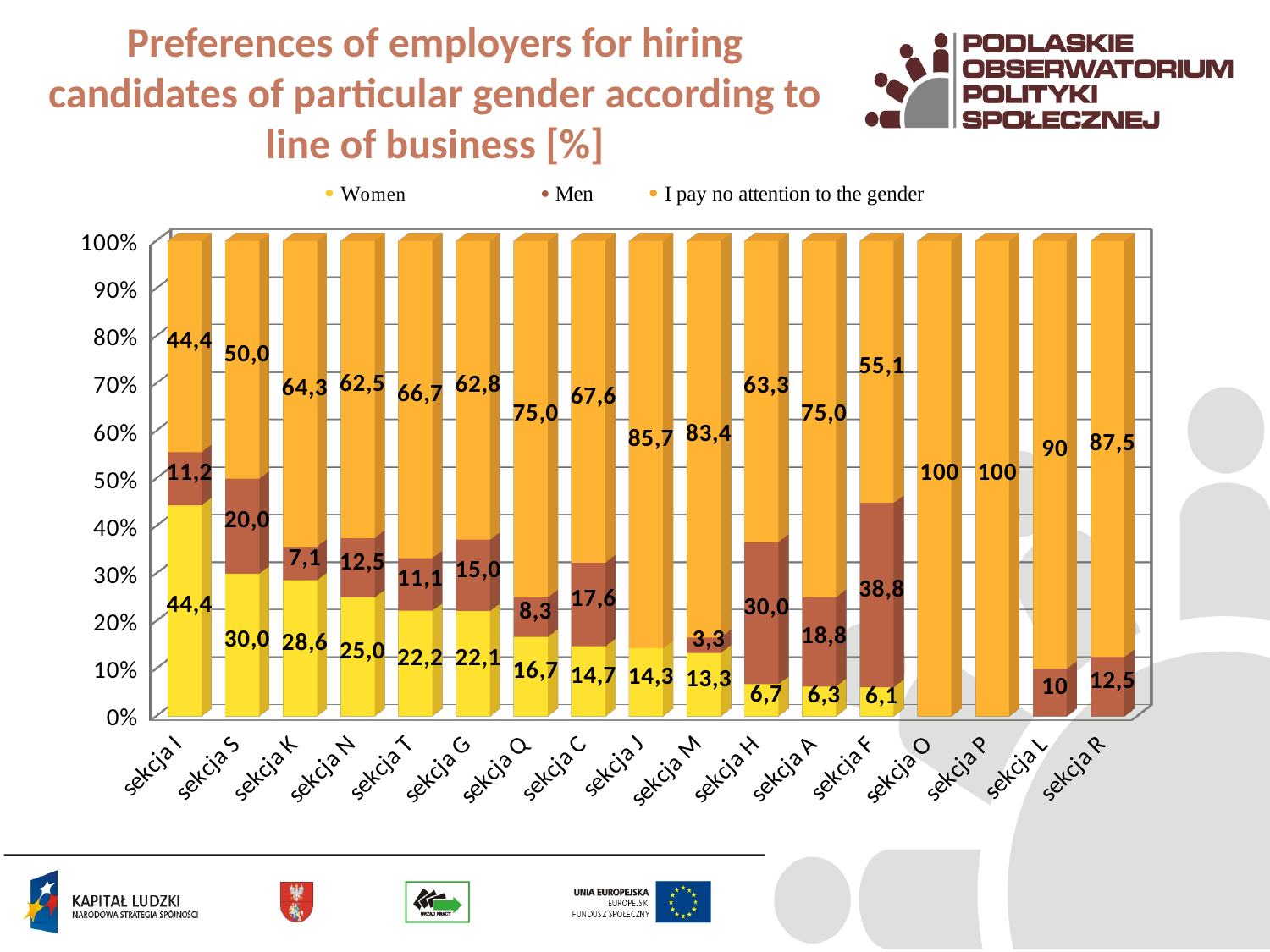
Which is larger, the Women value for sekcja S or the Women value for sekcja K? sekcja S What is the Men value for sekcja F? 38,8 Which category has the highest Women value? sekcja I What is the 'I pay no attention to the gender' value for sekcja J? 85,7 How many categories are shown on the x axis? 17 What kind of chart is shown on the slide? Stacked bar chart What is the Women value for sekcja I? 44,4 What is the Men value for sekcja H? 30,0 Which categories have a value of 100 for 'I pay no attention to the gender'? sekcja O and sekcja P How many series does the legend list? 3 What is the difference between the Men values for sekcja F and sekcja H? 8,8 Which category has the lowest Men value among those with a printed Men label? sekcja M